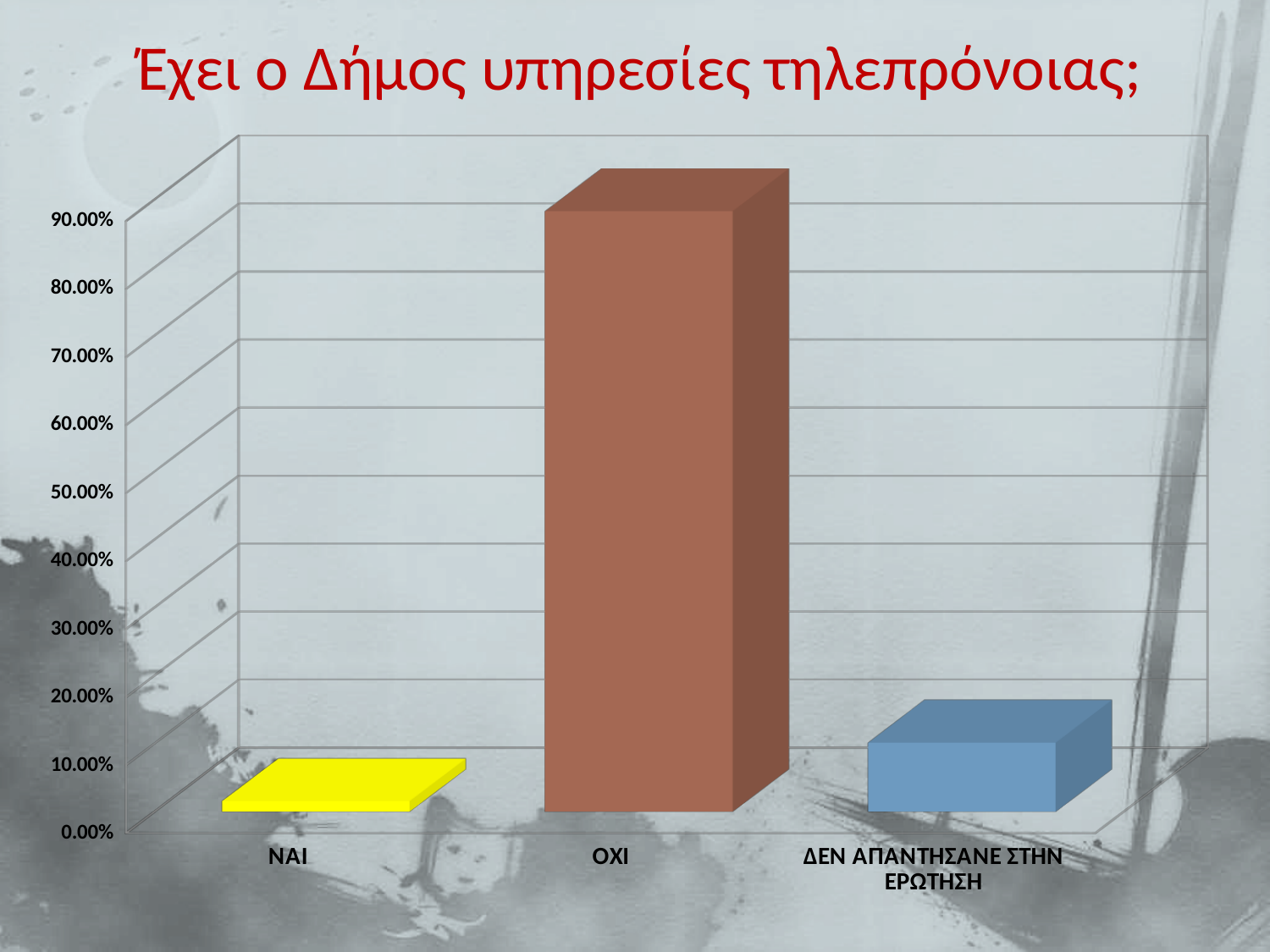
What kind of chart is shown on the slide? bar chart Is the value for ΔΕΝ ΑΠΑΝΤΗΣΑΝΕ ΣΤΗΝ ΕΡΩΤΗΣΗ greater or less than 20.00%? less Which is larger, the value for ΝΑΙ or the value for ΔΕΝ ΑΠΑΝΤΗΣΑΝΕ ΣΤΗΝ ΕΡΩΤΗΣΗ? ΔΕΝ ΑΠΑΝΤΗΣΑΝΕ ΣΤΗΝ ΕΡΩΤΗΣΗ Which category has the highest value? ΟΧΙ What is the title of the chart? Έχει ο Δήμος υπηρεσίες τηλεπρόνοιας; What colour is the bar for ΟΧΙ? brown Is the value for ΝΑΙ greater or less than 10.00%? less Is the value for ΟΧΙ greater or less than 80.00%? greater What is the highest tick label shown on the y axis? 90.00% Which is larger, the value for ΟΧΙ or the value for ΔΕΝ ΑΠΑΝΤΗΣΑΝΕ ΣΤΗΝ ΕΡΩΤΗΣΗ? ΟΧΙ How many categories are shown on the x axis? 3 Which category has the lowest value? ΝΑΙ